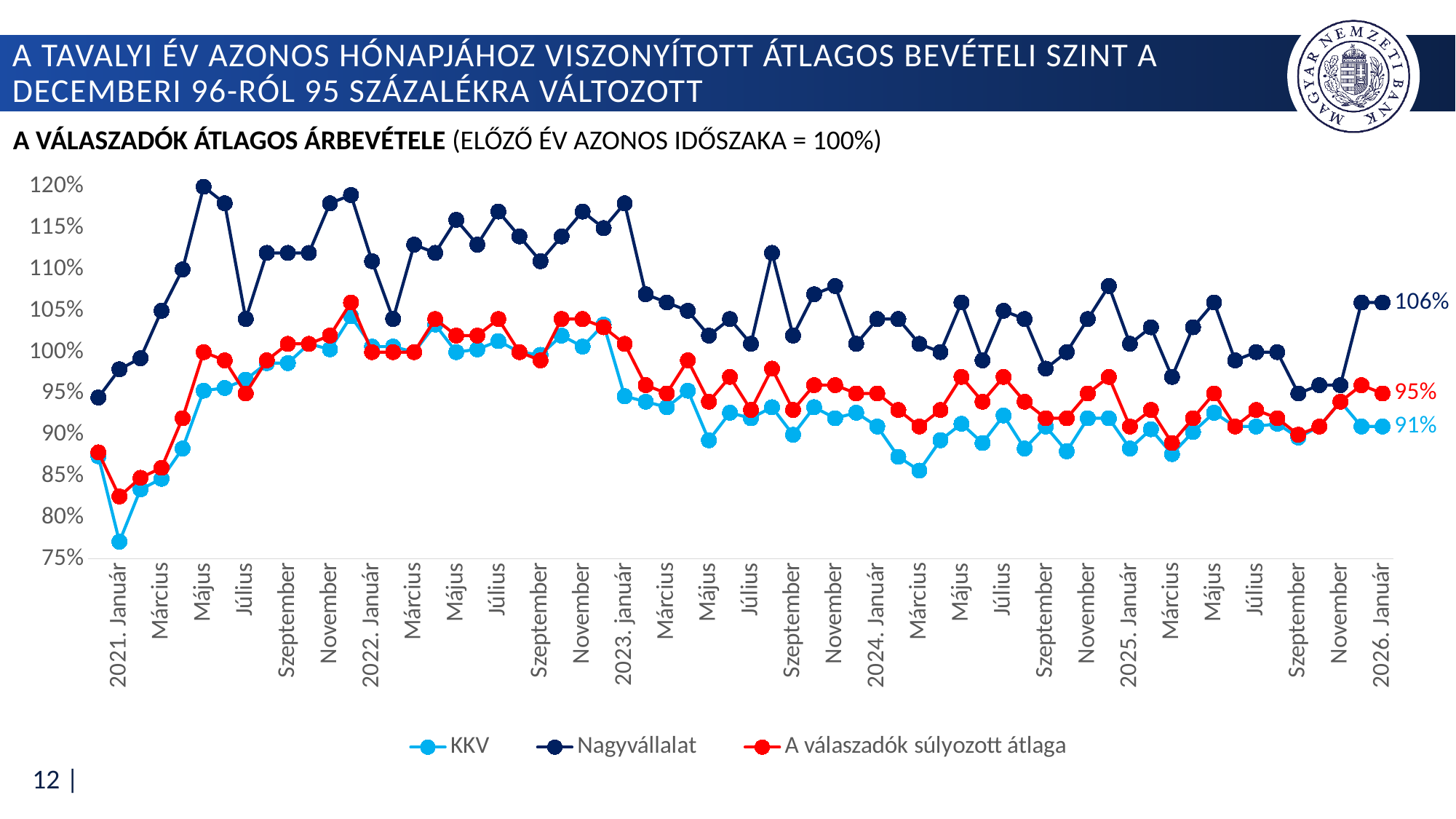
What is the value for A válaszadók súlyozott átlaga in 2026. január? 95% What are the three legend entries of the chart? KKV, Nagyvállalat, A válaszadók súlyozott átlaga What is the value for KKV in 2026. január? 91% Is the value for Nagyvállalat in 2021. május greater or less than 115%? greater Which series has the highest value in 2026. január? Nagyvállalat How many series does the legend list? 3 Is the value for KKV in 2021. január greater or less than 80%? less What kind of chart is shown on the slide? line chart What is the difference between the Nagyvállalat and KKV values in 2026. január? 15 percentage points In 2026. január, which is higher: KKV or Nagyvállalat? Nagyvállalat Is the value for A válaszadók súlyozott átlaga in 2021. január greater or less than 90%? less What is the value for Nagyvállalat in 2026. január? 106%